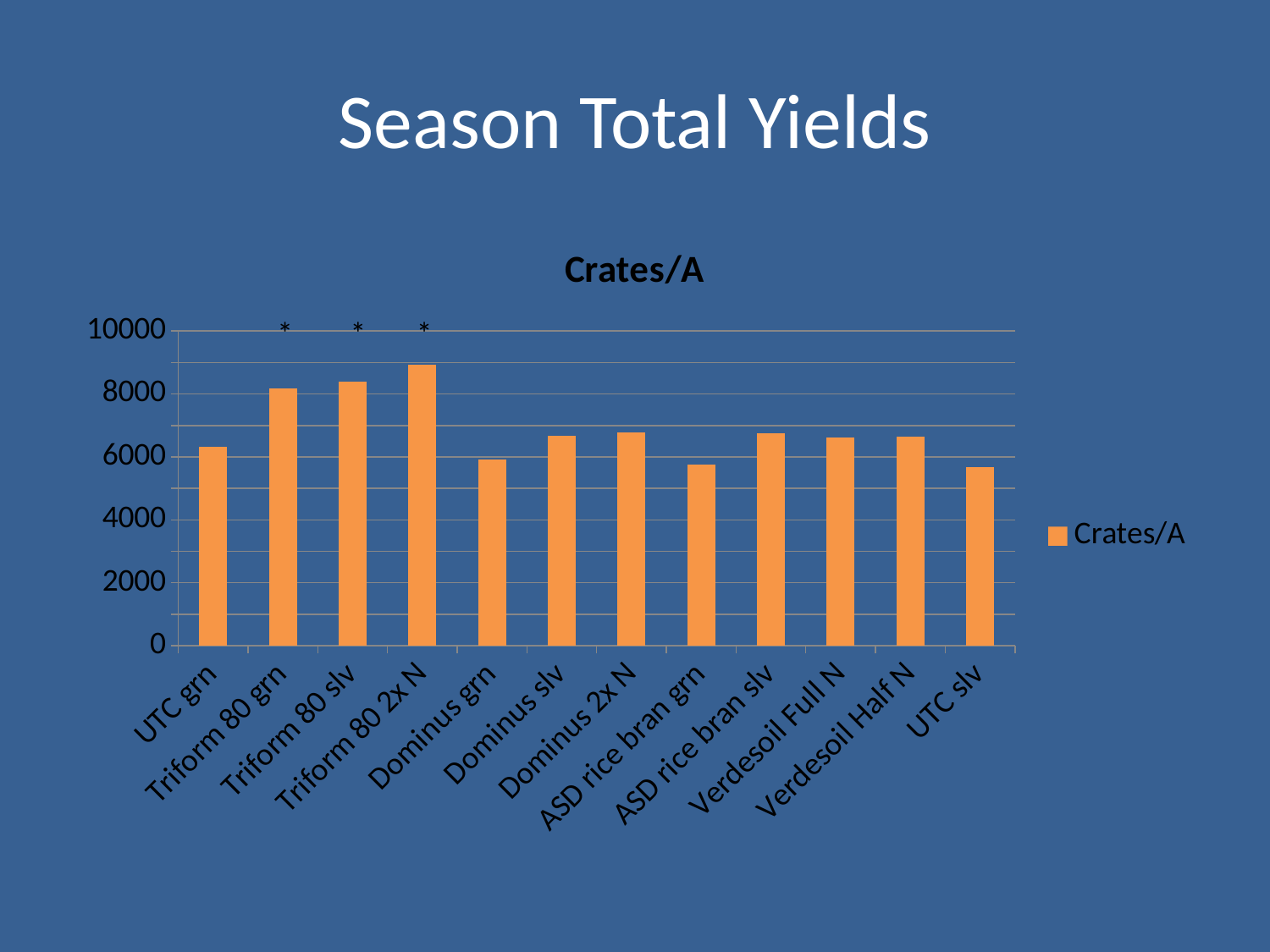
How many series does the chart legend list? 1 Which is larger, the value for Triform 80 grn or the value for Triform 80 2x N? Triform 80 2x N Is the value for UTC grn greater or less than 6000? greater Which is larger, the value for Triform 80 slv or the value for Dominus grn? Triform 80 slv Is the value for UTC slv greater or less than 6000? less What kind of chart is shown on the slide? Bar chart How many categories are plotted on the x axis of the chart? 12 What is the title of the chart? Crates/A Is the value for Triform 80 grn greater or less than 8000? greater Which category has the highest value in the chart? Triform 80 2x N